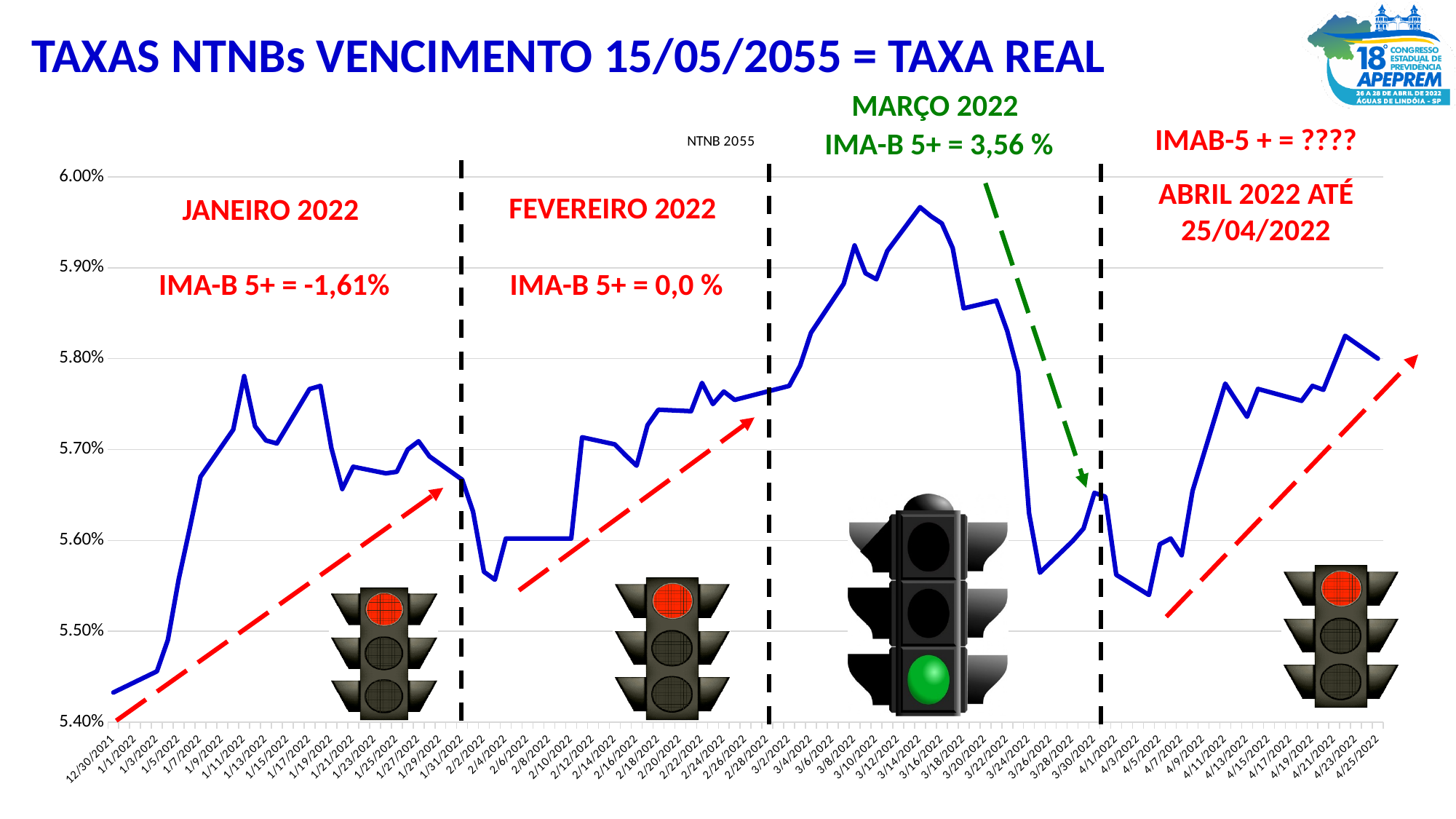
Do the values rise or fall between 12/30/2021 and 1/11/2022? rise Is the value for 12/30/2021 greater or less than 5.50%? less Is the value for 3/14/2022 greater or less than 5.90%? greater What is the title printed above the chart's plot area? NTNB 2055 Which is larger, the value for 1/11/2022 or the value for 2/4/2022? 1/11/2022 According to the annotation on the slide, what was IMA-B 5+ in March 2022 (MARÇO 2022)? 3,56 % Do the values rise or fall between 3/14/2022 and 3/26/2022? fall What kind of chart is shown on the slide? line chart Is the value for 1/11/2022 greater or less than 5.70%? greater Which date has the lowest value on the chart? 12/30/2021